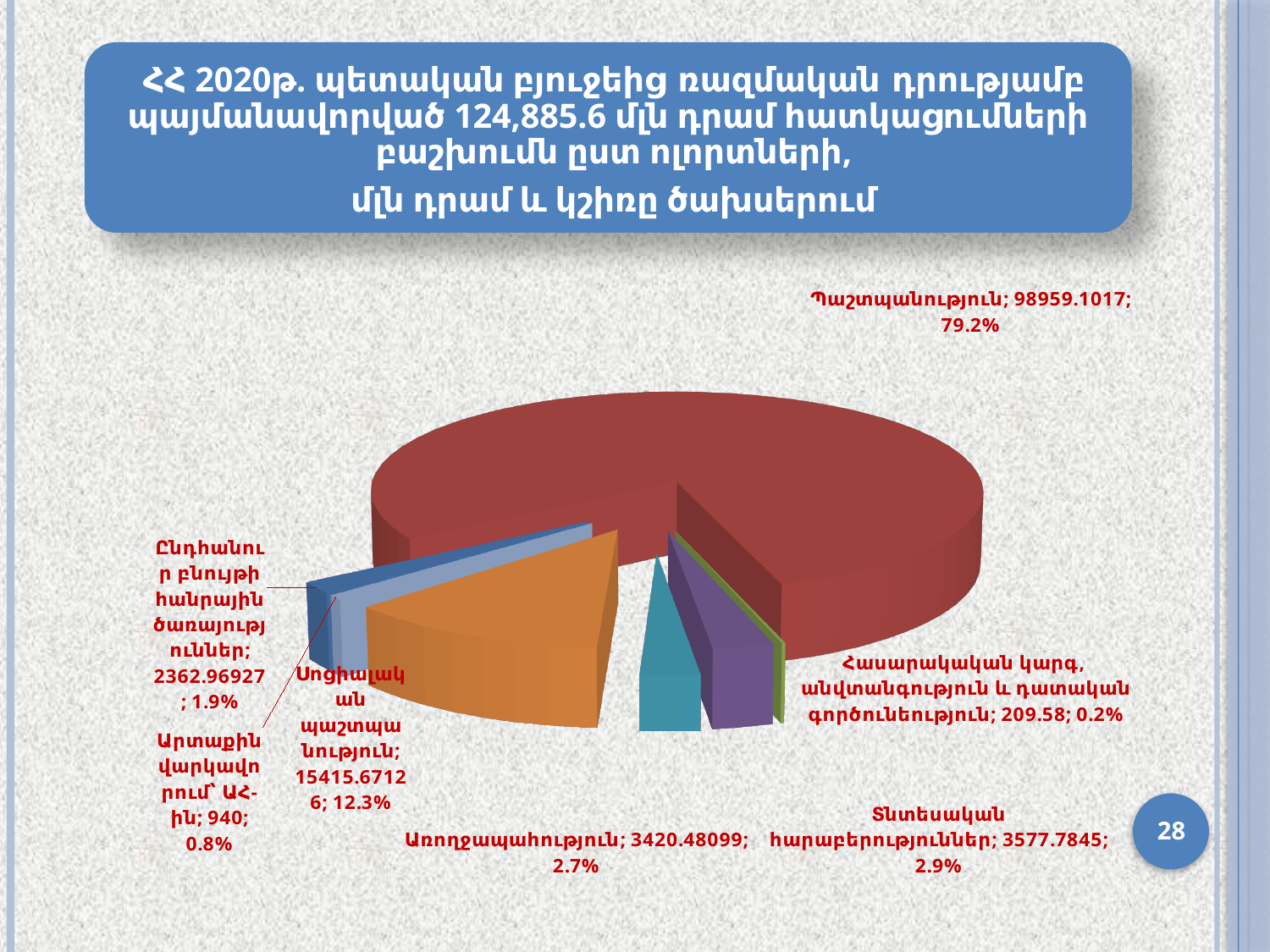
What percentage is shown for Առողջապահություն? 2.7% What percentage is shown for Ընդհանուր բնույթի հանրային ծառայություններ? 1.9% How many slices does the pie chart have? 7 What kind of chart is shown on the slide? pie chart What value is shown for Արտաքին վարկավորում ԱՀ-ին? 940 What is the difference between the values for Տնտեսական հարաբերություններ and Առողջապահություն? 157.30351 What share of the pie does Պաշտպանություն represent? 79.2% Which category has the largest slice of the pie? Պաշտպանություն What value is shown for Սոցիալական պաշտպանություն? 15415.67126 Which category has the smallest slice of the pie? Հասարակական կարգ, անվտանգություն և դատական գործունեություն Which is larger: the value for Տնտեսական հարաբերություններ or the value for Առողջապահություն? Տնտեսական հարաբերություններ What value is shown for Պաշտպանություն? 98959.1017